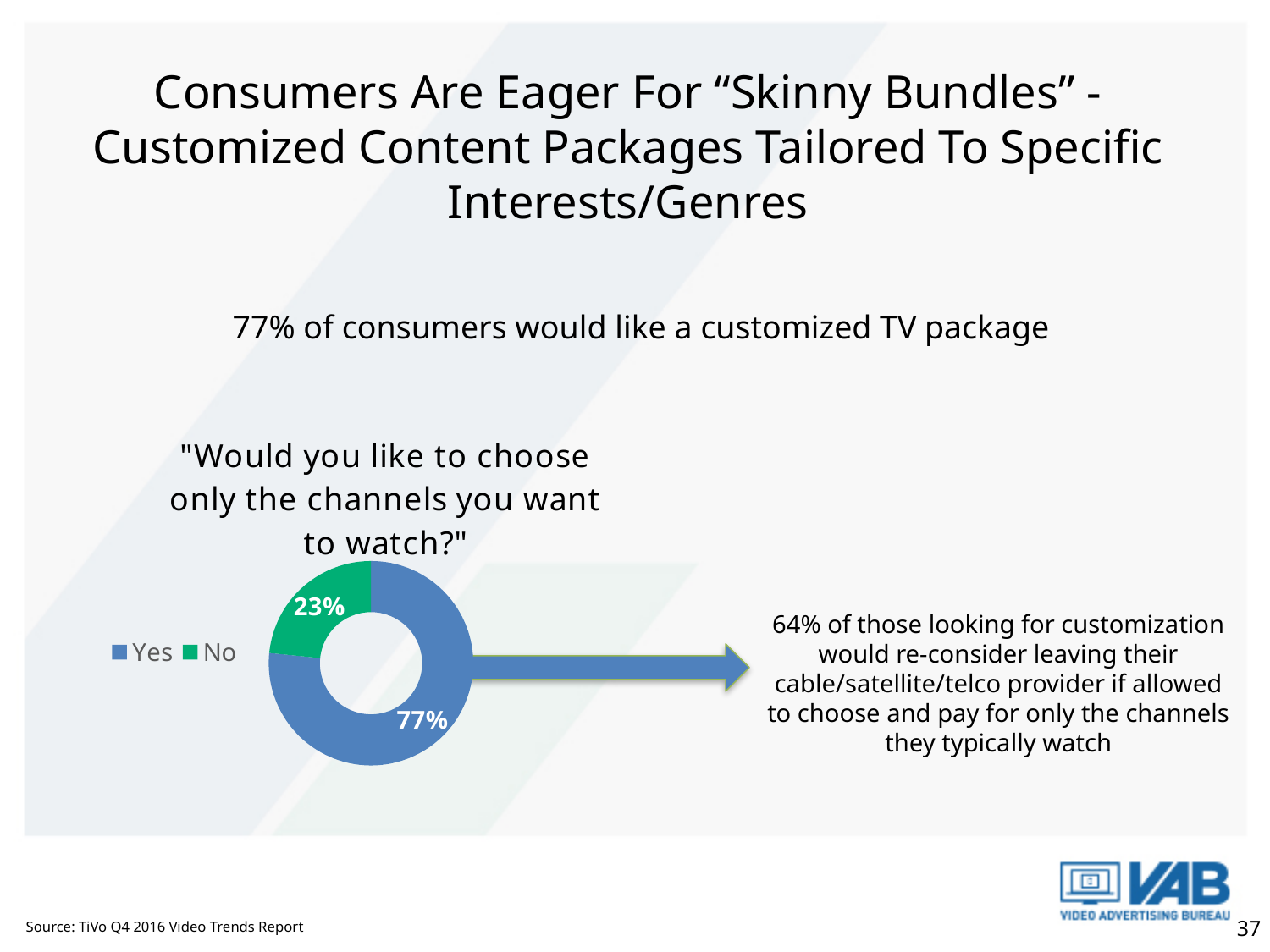
What kind of chart is shown on the slide? Doughnut chart What is the combined total of the Yes and No shares in the chart? 100% What percentage of respondents answered "Yes" to "Would you like to choose only the channels you want to watch?" 77% Which response has the larger share in the chart, Yes or No? Yes How many categories does the chart show? 2 How many entries does the chart legend list? 2 What percentage of respondents answered "No" in the doughnut chart? 23% Is the share for Yes greater or less than 50%? greater What is the difference in percentage points between the Yes and No shares? 54 What colour represents the "No" response in the chart? Green What is the title of the chart? "Would you like to choose only the channels you want to watch?" Which category has the smallest share in the doughnut chart? No